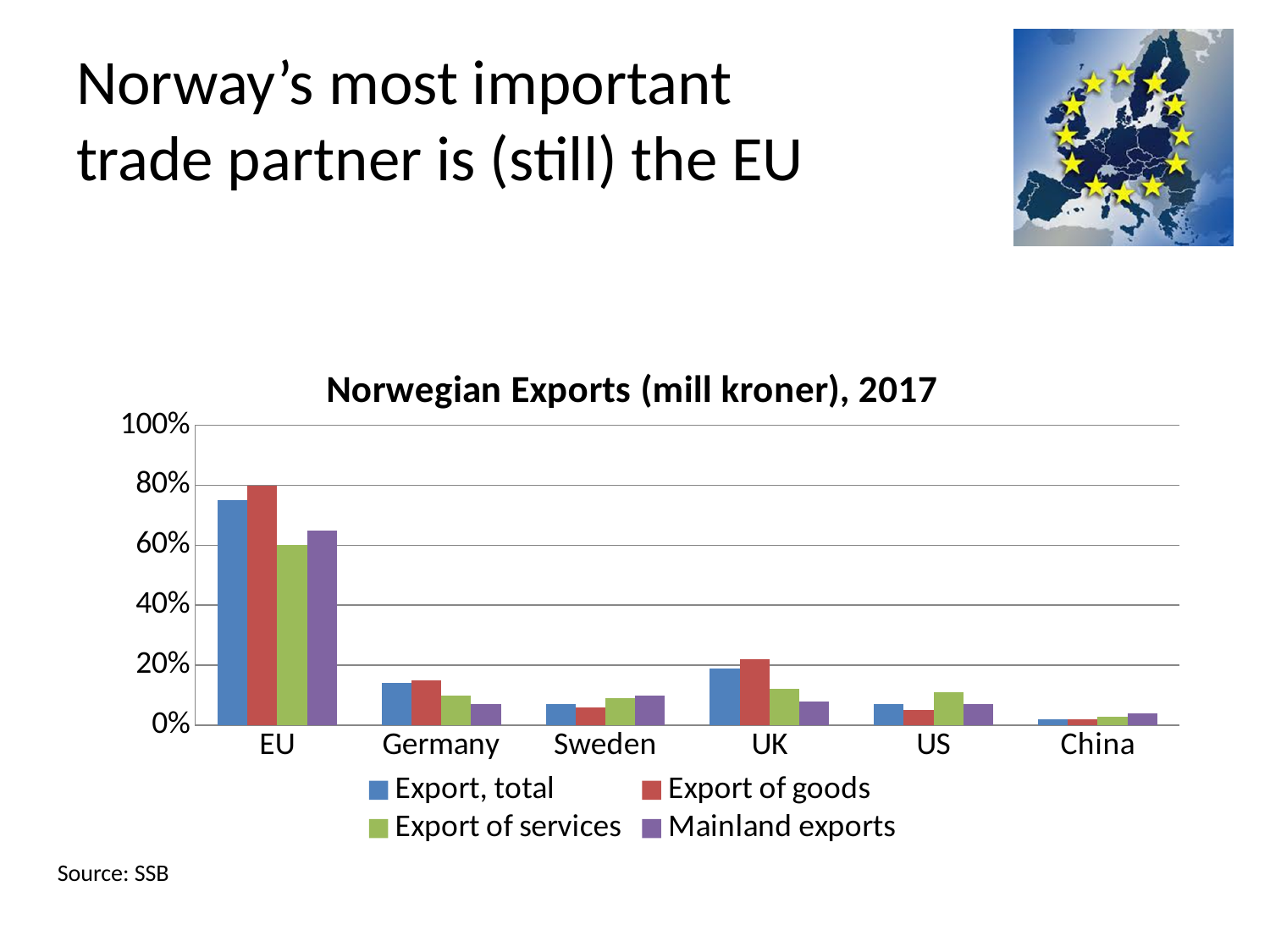
What is the title of the chart? Norwegian Exports (mill kroner), 2017 Which is larger for Export of services: the US or China? US How many series does the chart's legend list? 4 Which series is shown in green in the legend? Export of services What kind of chart is shown on the slide? bar chart Which category has the lowest value for Export of goods? China Which is larger for Export of goods: the UK or Germany? UK Which category has the highest value for Export, total? EU Is the value for Export, total for the EU greater or less than 60%? greater Is the value for Export of goods for the UK greater or less than 40%? less Is the value for Export of services for the EU greater or less than 40%? greater How many trade partner categories are shown on the x axis? 6